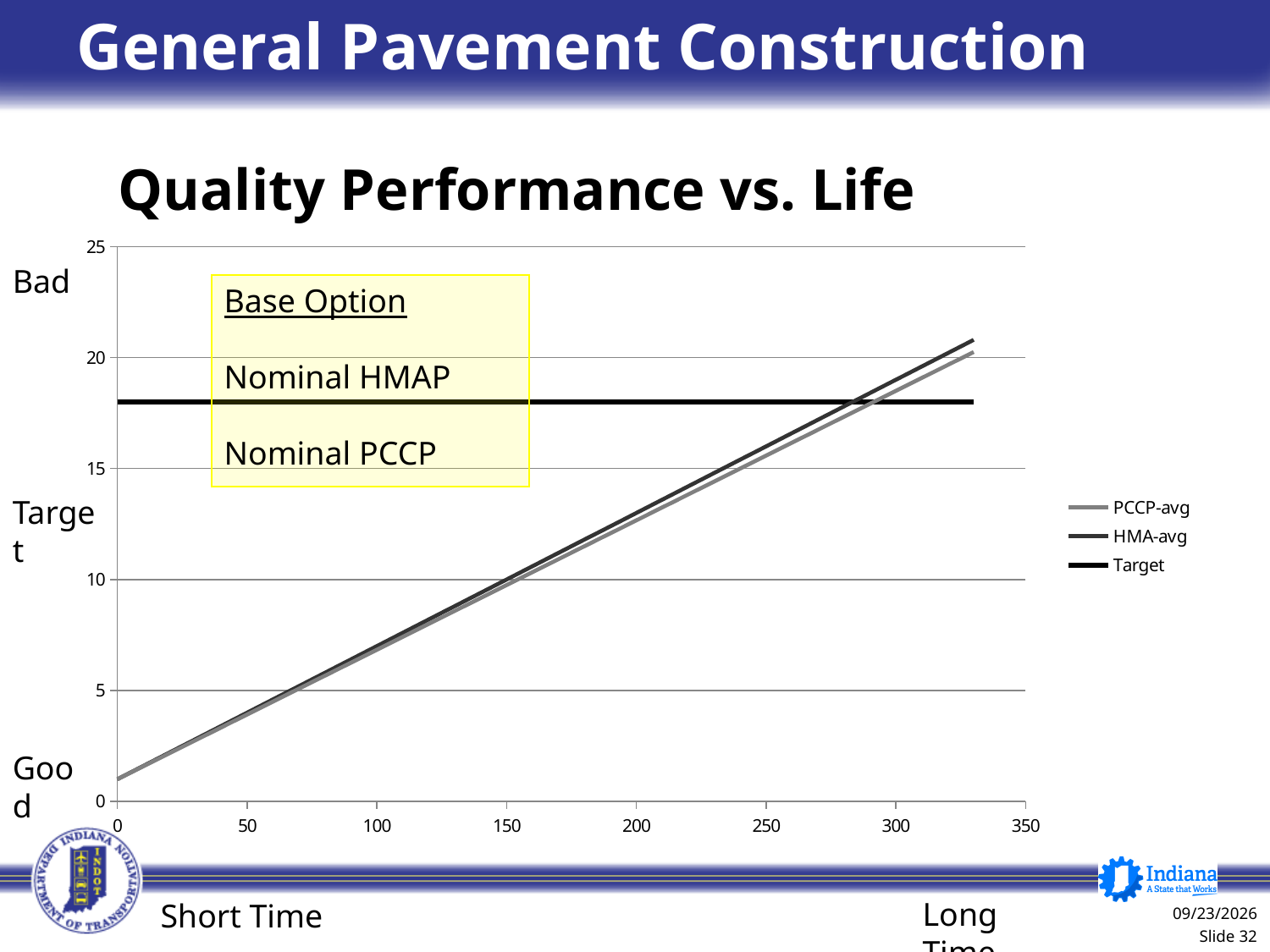
Is the value for PCCP-avg at x = 300 greater or less than 15? greater Is the value for HMA-avg at x = 50 greater or less than 5? less Is the value for HMA-avg at x = 100 greater or less than 10? less Do the HMA-avg values rise or fall as the x axis increases? rise What kind of chart is shown on the slide? line chart Which series are listed in the chart legend? PCCP-avg, HMA-avg, Target What is the title of the chart? Quality Performance vs. Life Do the PCCP-avg values rise or fall as the x axis increases? rise How many series does the chart legend list? 3